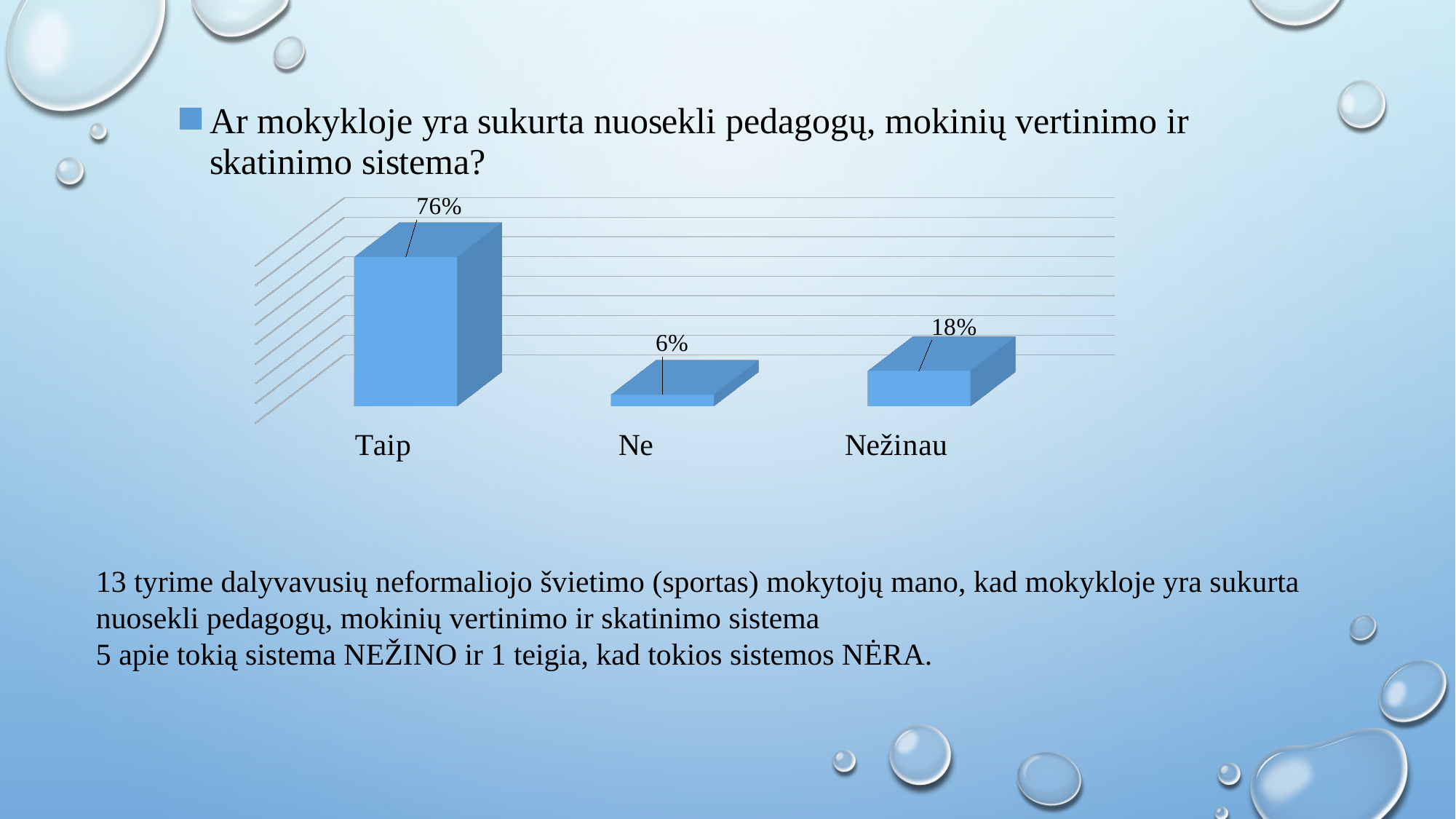
Which is larger, the value for Ne or the value for Nežinau? Nežinau What is the value for Ne? 6% What is the total of the three values shown in the chart? 100% What is the difference between the values for Nežinau and Ne? 12% What is the value for Nežinau? 18% What colour are the bars in the chart? blue Which category has the lowest value? Ne What kind of chart is shown on the slide? bar chart How many categories are shown in the chart? 3 What is the value for Taip? 76% What is the difference between the values for Taip and Nežinau? 58% Which category has the highest value? Taip